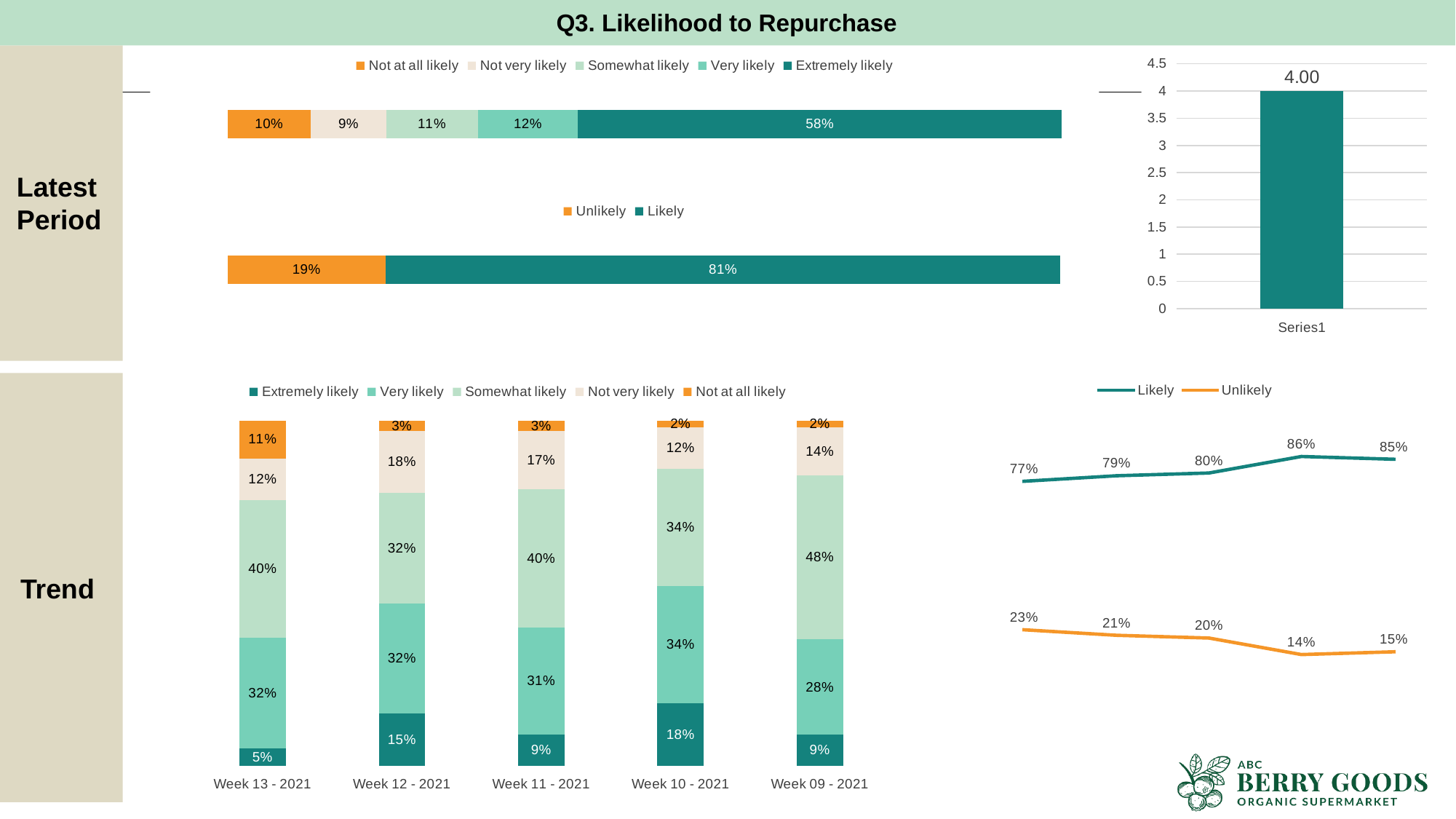
In the 'Unlikely / Likely' bar chart in the latest period section, what percentage is 'Likely'? 81% In the trend stacked bar chart at the bottom left, which week has the highest 'Somewhat likely' percentage? Week 09 - 2021 In the line chart at the bottom right, what is the 'Likely' value at the fourth point from the left? 86% What kind of chart is shown at the bottom right of the slide? Line chart In the trend stacked bar chart at the bottom left, what percentage is 'Extremely likely' for Week 10 - 2021? 18% How many series does the legend of the top-left stacked bar chart list? 5 In the top-left stacked bar chart for the latest period, what percentage is shown for 'Not at all likely'? 10% In the 'Unlikely / Likely' bar chart in the latest period section, what is the difference between the 'Likely' and 'Unlikely' percentages? 62% In the line chart at the bottom right, which series has the lower values, 'Likely' or 'Unlikely'? Unlikely In the top-left stacked bar chart for the latest period, what percentage is shown for 'Extremely likely'? 58% In the bar chart at the top right of the slide, what value is labelled on the Series1 bar? 4.00 In the trend stacked bar chart at the bottom left, how many weeks are shown on the x axis? 5